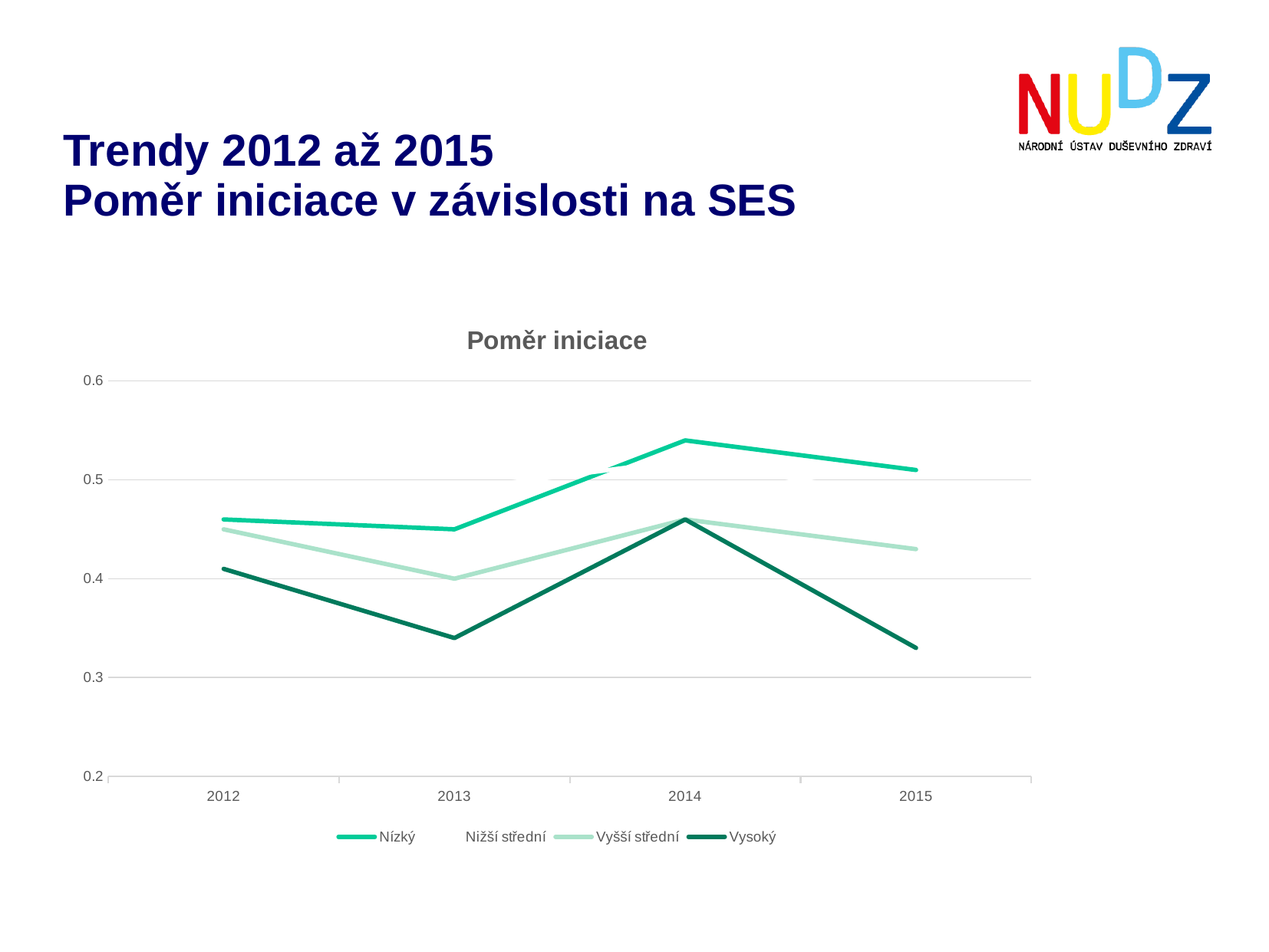
Is the value for Vysoký in 2015 greater or less than 0.4? less Does the Vysoký series rise or fall from 2014 to 2015? fall In which year does the Nízký series reach its highest value? 2014 Is the value for Vysoký in 2013 greater or less than 0.4? less Is the value for Nízký in 2014 greater or less than 0.5? greater In 2013, which is larger: the value for Nízký or the value for Vysoký? Nízký What is the title of the chart? Poměr iniciace Which series has the lowest value in 2015? Vysoký How many years are shown on the x axis? 4 What kind of chart is shown on the slide? line chart How many series does the legend list? 4